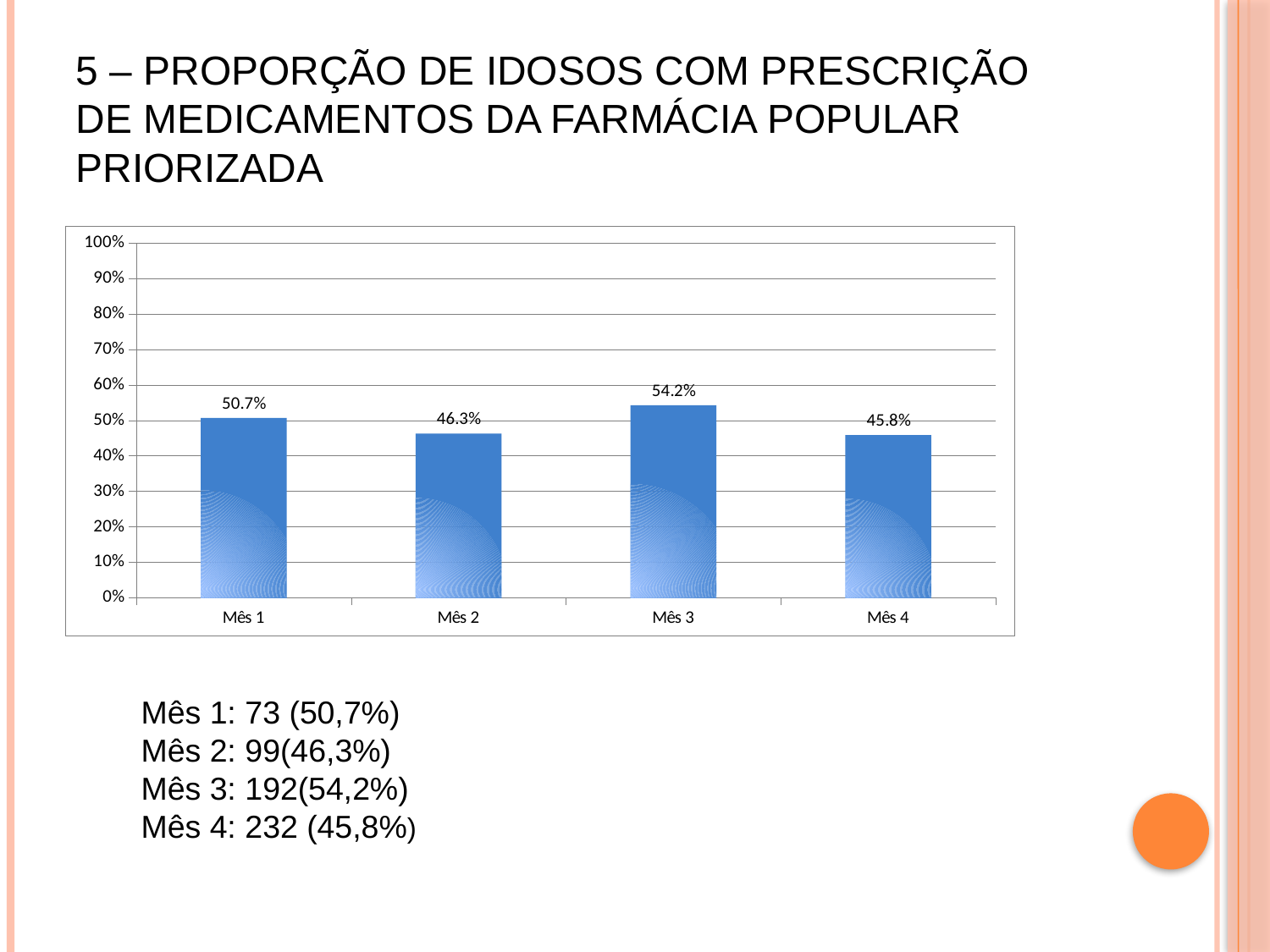
What is the difference between the values for Mês 3 and Mês 2? 7.9% How many months are shown on the x axis? 4 What kind of chart is shown on the slide? bar chart Which month has the lowest value? Mês 4 What is the value for Mês 3? 54.2% Which is larger, the value for Mês 1 or the value for Mês 2? Mês 1 Is the value for Mês 3 greater or less than 50%? greater What is the value for Mês 4? 45.8% Which month has the highest value? Mês 3 Does the value rise or fall from Mês 3 to Mês 4? fall What is the value for Mês 1? 50.7% What is the maximum value shown on the y axis? 100%